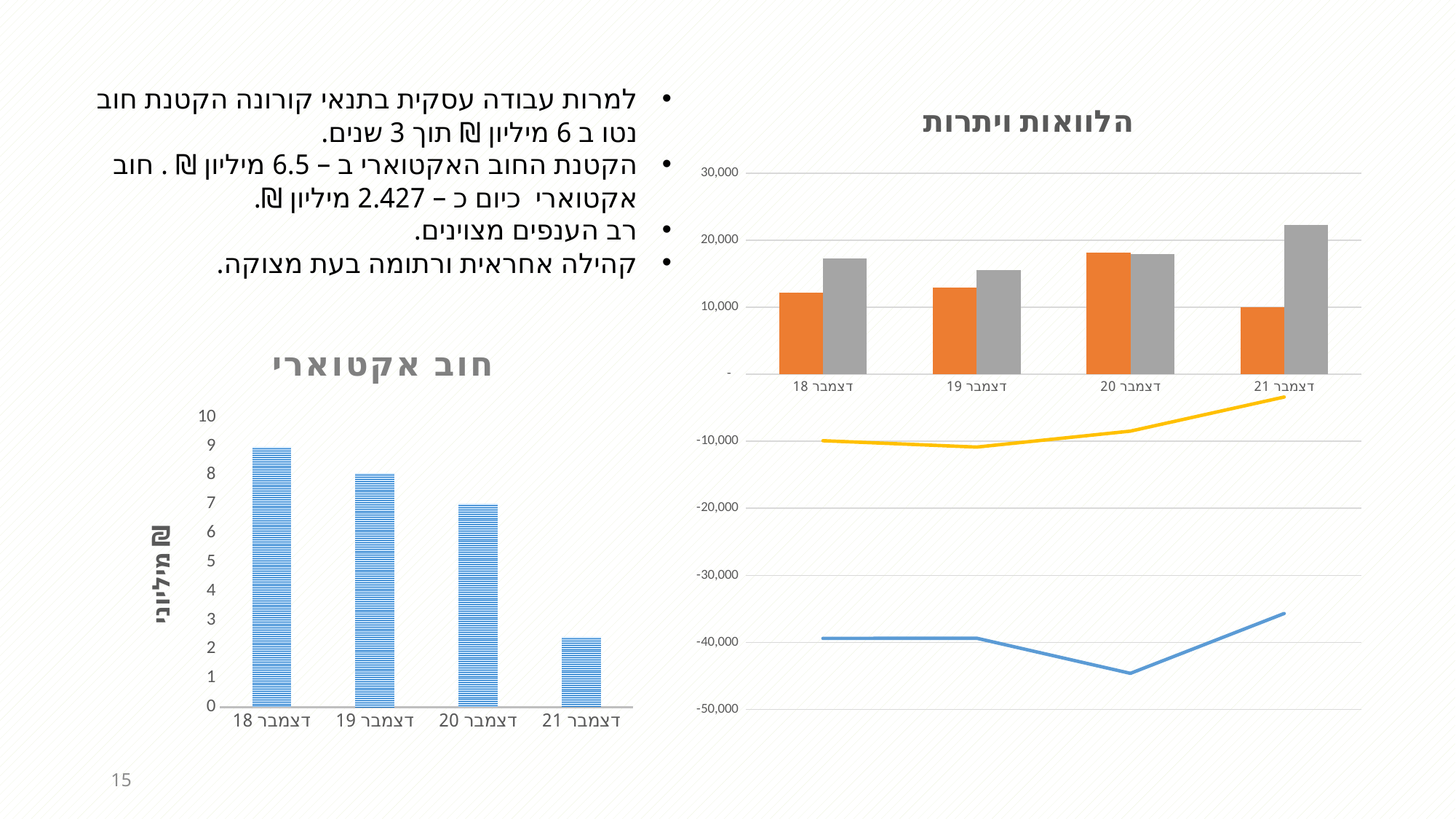
In the 'חוב אקטוארי' chart, which category has the highest bar? דצמבר 18 In the 'חוב אקטוארי' chart, do the values rise or fall from דצמבר 18 to דצמבר 21? fall In the 'הלוואות ויתרות' chart, is the gray bar for דצמבר 21 greater or less than 20,000? greater In the 'חוב אקטוארי' chart, how many categories are shown on the x axis? 4 In the 'חוב אקטוארי' chart, which category has the lowest bar? דצמבר 21 In the 'חוב אקטוארי' chart, which is larger, the bar for דצמבר 19 or the bar for דצמבר 20? דצמבר 19 What type of chart is the 'חוב אקטוארי' chart on the left of the slide? bar chart In the 'הלוואות ויתרות' chart, which category has the tallest gray bar? דצמבר 21 In the 'חוב אקטוארי' chart, is the value for דצמבר 21 greater or less than 3? less What is the y-axis title of the 'חוב אקטוארי' chart? מיליוני ₪ In the 'הלוואות ויתרות' chart, at which category does the blue line reach its lowest point? דצמבר 20 In the 'חוב אקטוארי' chart, is the value for דצמבר 18 greater or less than 8? greater